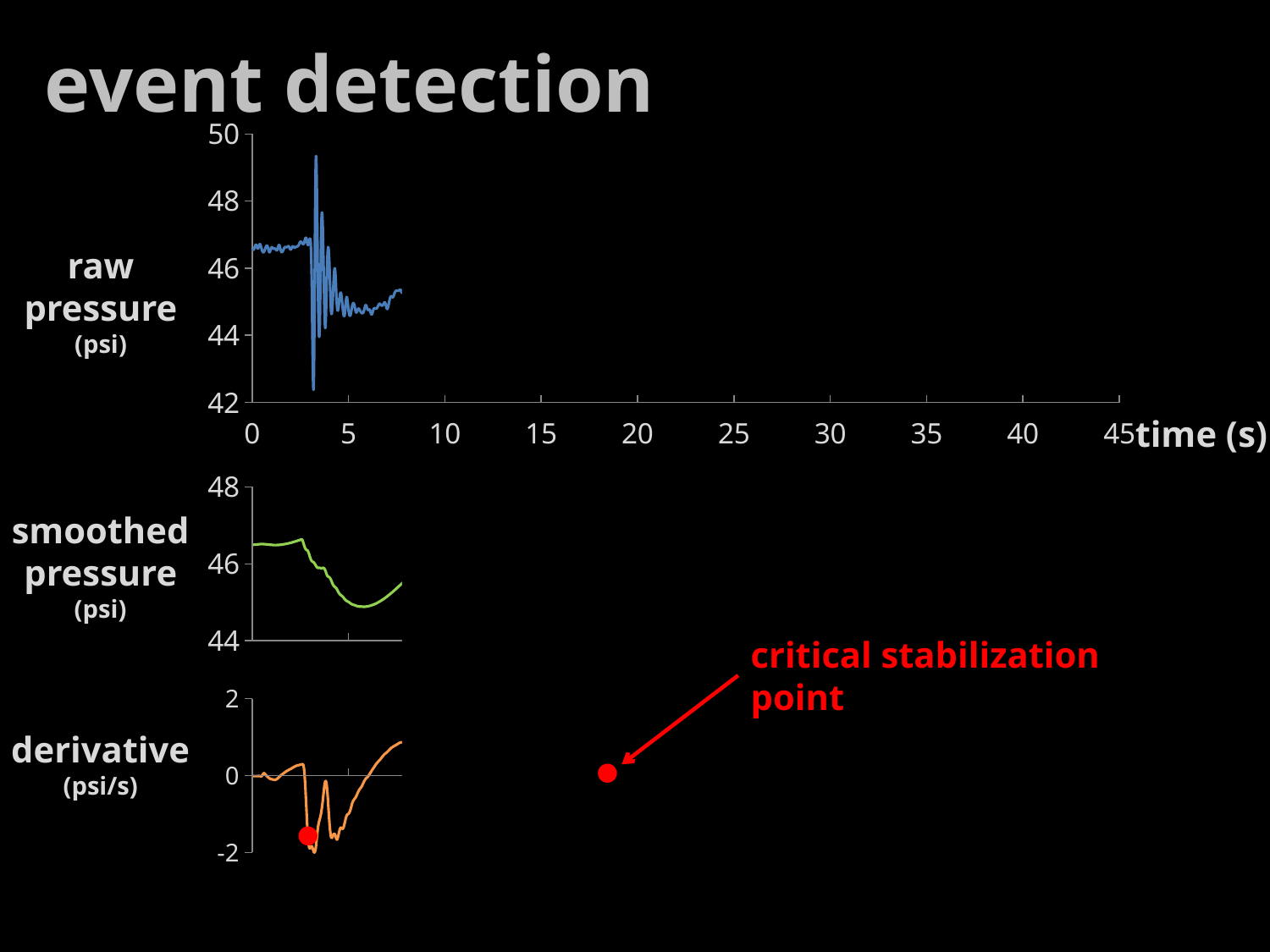
In the raw pressure chart, is the lowest dip greater or less than 44? less In the raw pressure chart, is the value at time 0 greater or less than 46? greater How many charts are shown on the slide? 3 What is the label of the x axis on the raw pressure chart? time (s) In the smoothed pressure chart, does the line rise or fall between time 0 and time 5? fall In the derivative chart, is the lowest point of the line greater or less than 0? less What is the unit shown for the derivative chart's y axis? psi/s What kind of chart is the derivative chart? line chart What kind of chart is the raw pressure chart? line chart